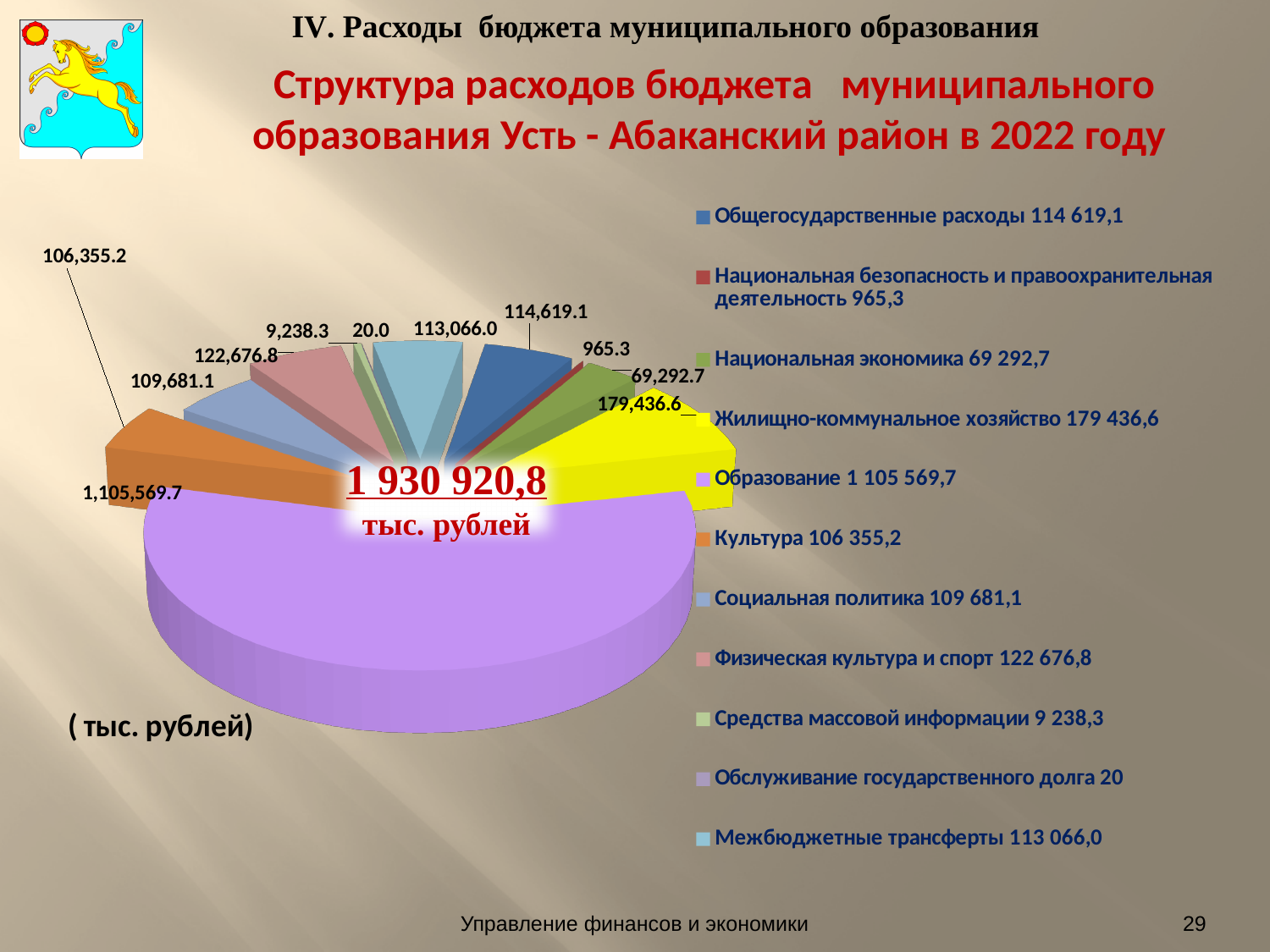
Which is larger, Межбюджетные трансферты or Общегосударственные расходы? Общегосударственные расходы What total is printed in the centre of the pie chart? 1 930 920,8 тыс. рублей What is the value for Жилищно-коммунальное хозяйство? 179,436.6 What is the value for Образование? 1,105,569.7 Which category has the smallest value? Обслуживание государственного долга What is the value for Средства массовой информации? 9,238.3 How many categories does the pie chart have? 11 What is the difference between Жилищно-коммунальное хозяйство and Общегосударственные расходы? 64,817.5 What kind of chart is shown on the slide? Pie chart Which category has the largest value? Образование Which is larger, Культура or Социальная политика? Социальная политика What is the value for Национальная безопасность и правоохранительная деятельность? 965.3